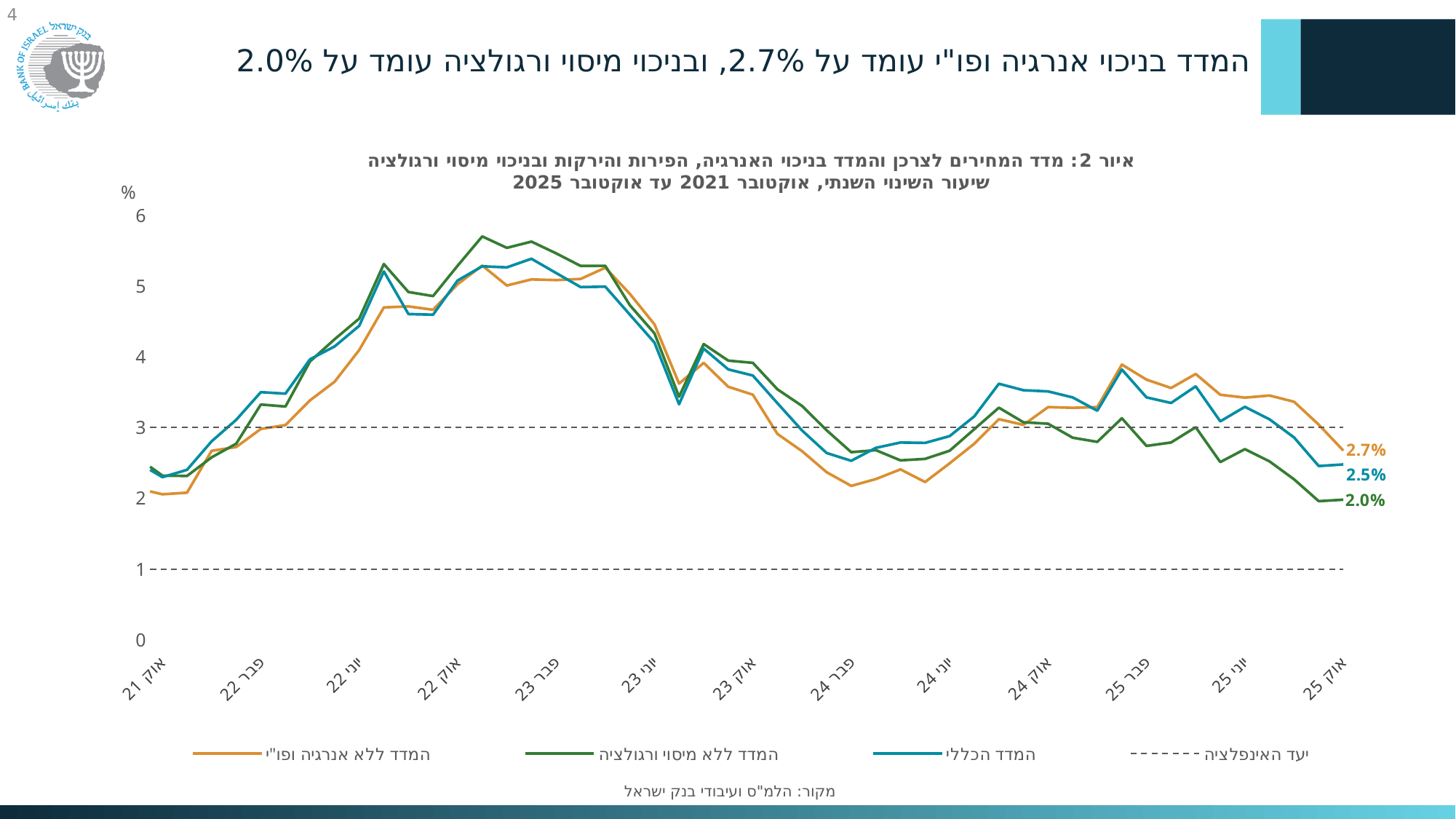
What is the difference between the final labelled values of "המדד ללא אנרגיה ופו"י" (2.7%) and "המדד ללא מיסוי ורגולציה" (2.0%)? 0.7 percentage points Between "פבר 25" and "אוק 25", does the orange line ("המדד ללא אנרגיה ופו"י") rise or fall overall? Fall At the right end of the chart, which is larger: the value of "המדד הכללי" or the value of "המדד ללא מיסוי ורגולציה"? המדד הכללי What is the latest value shown for the series "המדד הכללי" (the blue line) at the right end of the chart? 2.5% What kind of chart is shown on the slide? Line chart How many entries does the chart legend list? 4 Which series has the highest value at the right end of the chart (October 2025)? המדד ללא אנרגיה ופו"י Is the value of the orange line ("המדד ללא אנרגיה ופו"י") at "פבר 24" greater or less than 3? less What is the latest value shown for the series "המדד ללא מיסוי ורגולציה" (the green line) at the right end of the chart? 2.0% Is the value of the green line ("המדד ללא מיסוי ורגולציה") at "פבר 23" greater or less than 5? greater Which series has the lowest value at the right end of the chart (October 2025)? המדד ללא מיסוי ורגולציה What is the latest value shown for the series "המדד ללא אנרגיה ופו"י" (the orange line) at the right end of the chart? 2.7%